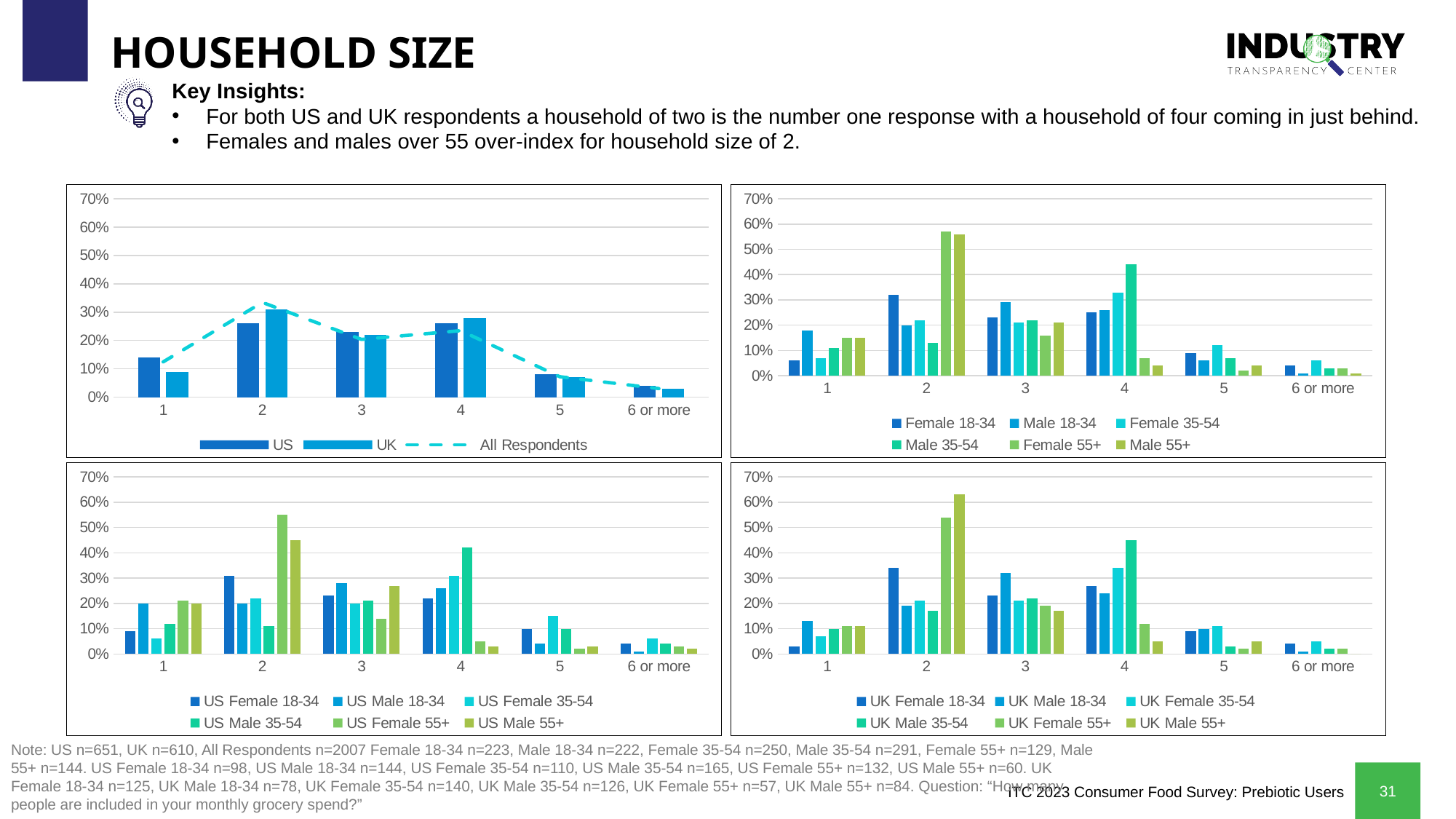
In the top-left chart, how many household size categories are shown on the x axis? 6 In the top-left chart, which household size has the lowest US value? 6 or more In the top-right chart, is the Female 18-34 value for household size 1 greater or less than 10%? less In the top-right chart, how many series does the legend list? 6 In the bottom-left chart, for household size 2, which is larger: US Female 55+ or US Male 55+? US Female 55+ In the bottom-left chart, is the US Female 55+ value for household size 2 greater or less than 50%? greater In the bottom-right chart, for household size 2, which is larger: UK Female 55+ or UK Male 55+? UK Male 55+ In the top-left chart, how many series does the legend list? 3 In the bottom-right chart, is the UK Male 55+ value for household size 2 greater or less than 60%? greater In the top-left chart, which household size has the highest UK value? 2